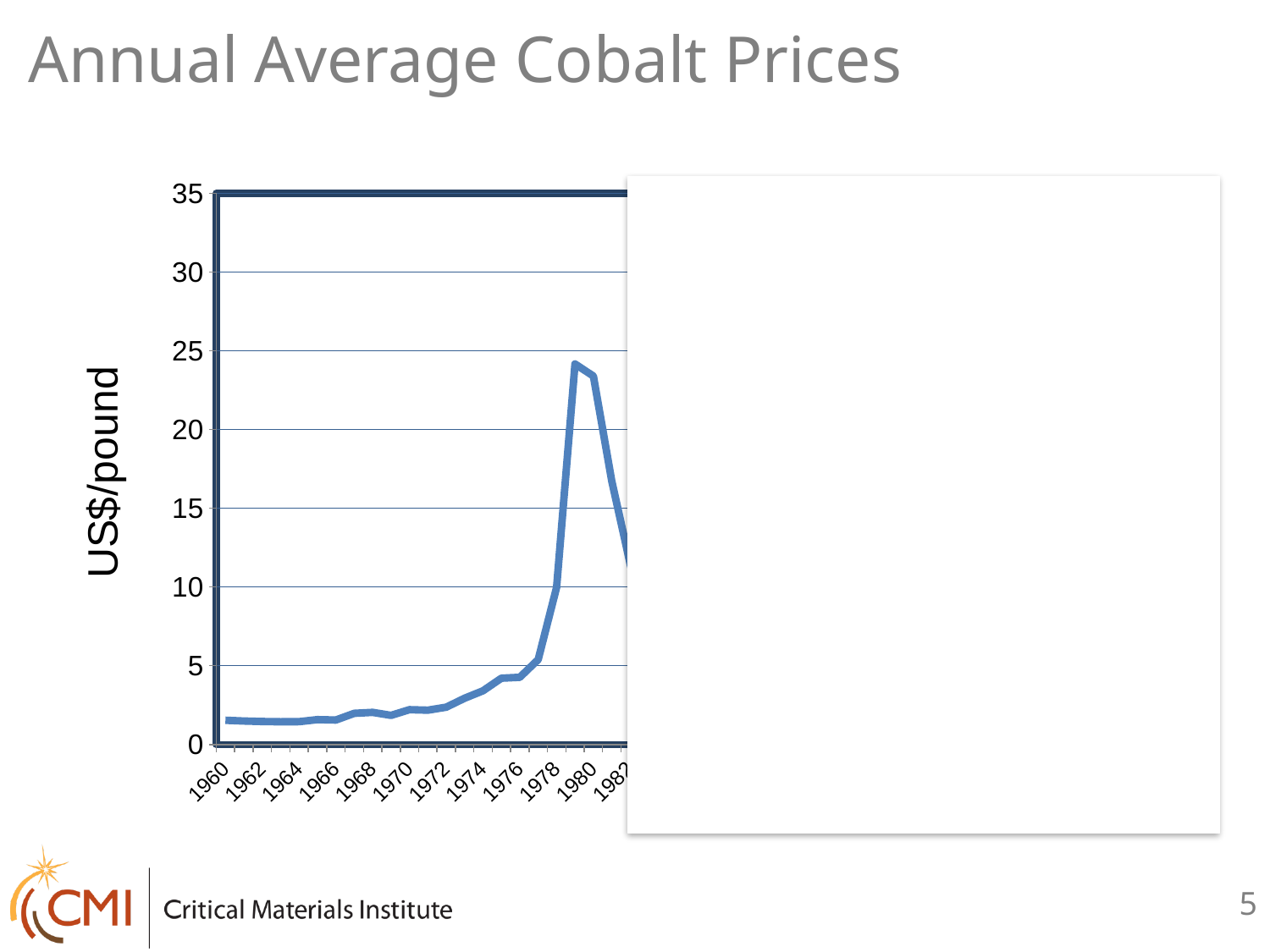
What is the title of the chart on the slide? Annual Average Cobalt Prices Is the value for 1979 greater or less than 20? greater Which of the visible years has the highest cobalt price? 1979 Do cobalt prices rise or fall from 1960 to 1979? rise What is the label on the y axis of the chart? US$/pound Is the value for 1979 greater or less than 30? less Is the value for 1970 greater or less than 5? less What kind of chart is shown on the slide? line chart Which is larger, the value for 1979 or the value for 1976? 1979